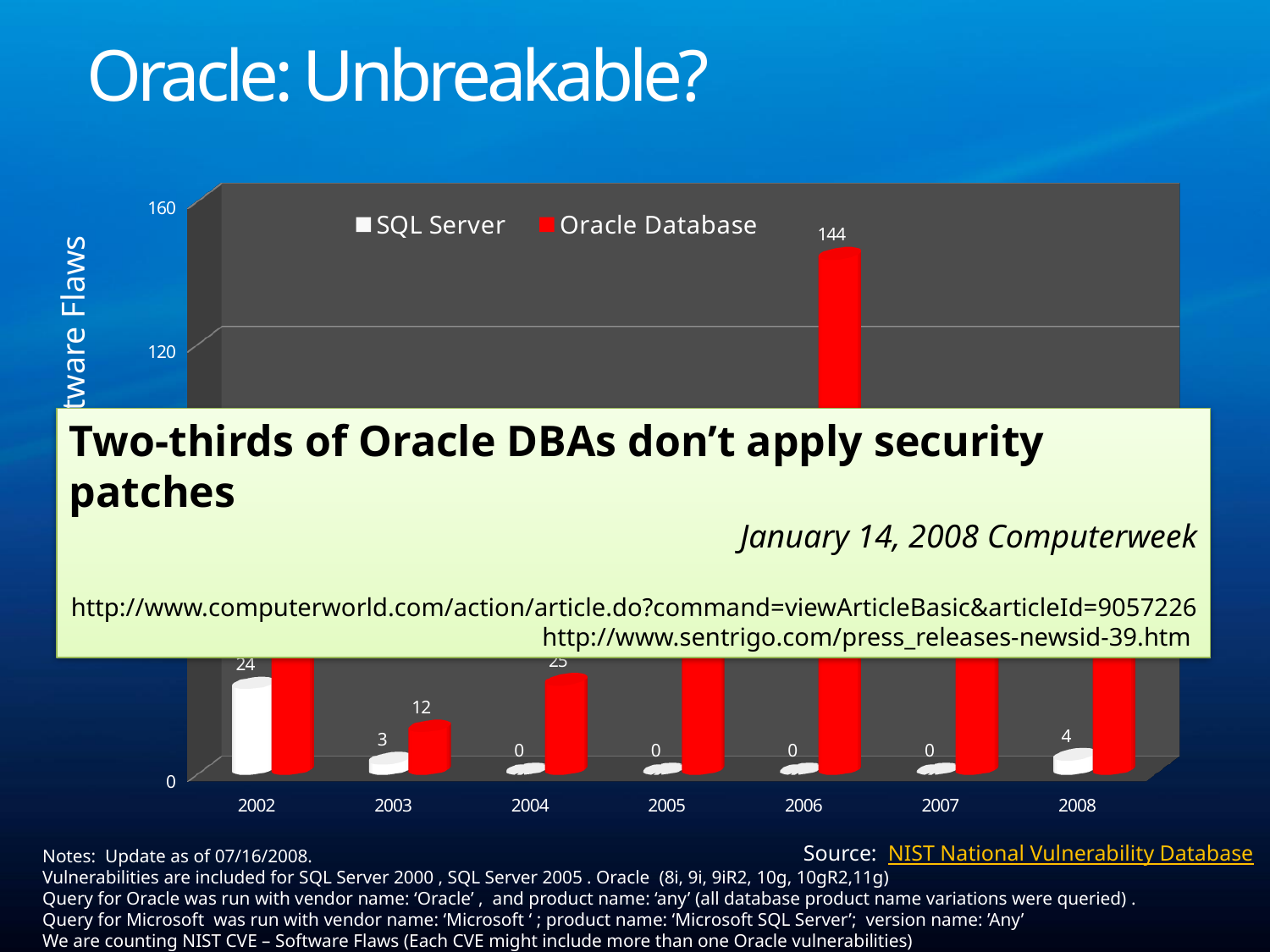
How many years are shown on the x axis of the chart? 7 How many series does the chart legend list? 2 What kind of chart is shown on the slide? bar chart What is the value for SQL Server in 2008? 4 Which colour represents Oracle Database in the chart? red What is the value for SQL Server in 2002? 24 In which year is the SQL Server value highest? 2002 What is the value for Oracle Database in 2003? 12 In which year is the Oracle Database value highest? 2006 In 2003, which series has the larger value, SQL Server or Oracle Database? Oracle Database What is the value for Oracle Database in 2006? 144 What is the difference between the Oracle Database and SQL Server values in 2003? 9